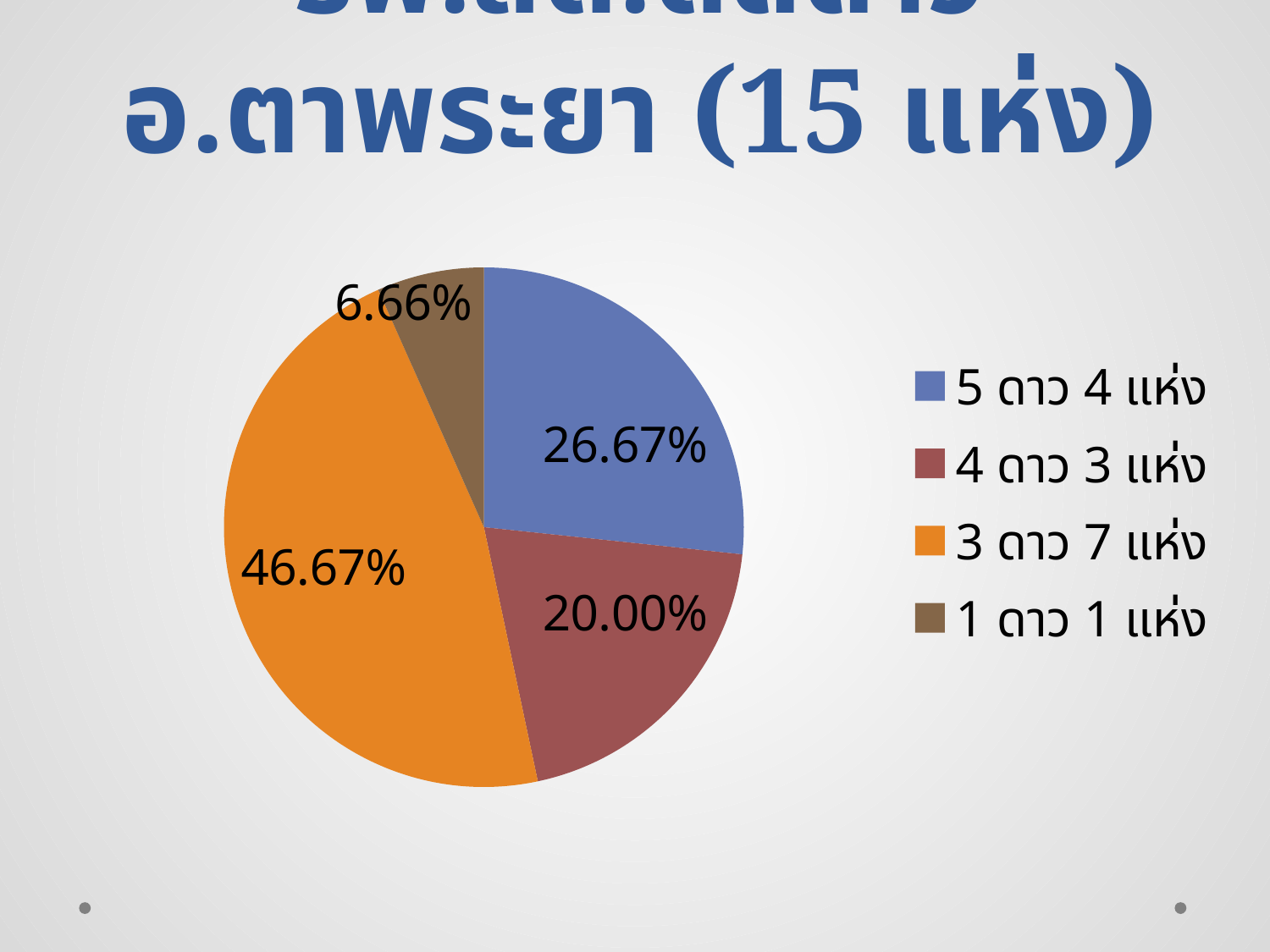
What type of chart is shown on the slide? pie chart What percentage is shown for the 4 ดาว slice? 20.00% What colour is the slice for 3 ดาว 7 แห่ง? orange How many slices does the pie chart have? 4 What percentage is shown for the 1 ดาว slice? 6.66% Which category has the smallest share of the pie? 1 ดาว 1 แห่ง Which category has the largest share of the pie? 3 ดาว 7 แห่ง How many entries does the legend list? 4 What percentage is shown for the 3 ดาว slice? 46.67% Which slice is larger: 5 ดาว or 4 ดาว? 5 ดาว What is the difference in percentage points between the 3 ดาว slice and the 5 ดาว slice? 20.00% What percentage is shown for the 5 ดาว slice? 26.67%